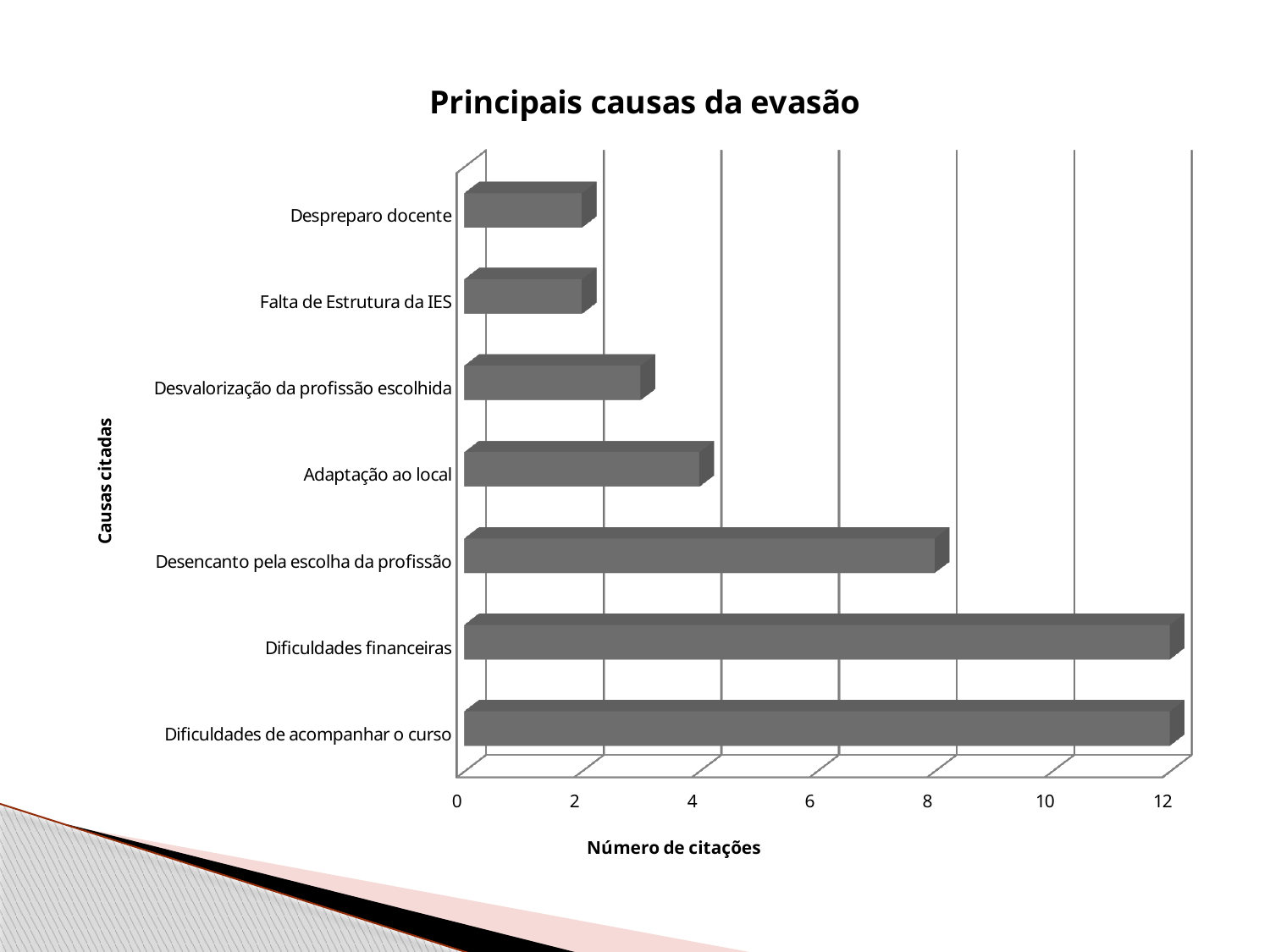
What is the number of citations for Desencanto pela escolha da profissão? 8 Which has more citations, Dificuldades financeiras or Desencanto pela escolha da profissão? Dificuldades financeiras Is the value for Desvalorização da profissão escolhida greater or less than 2? greater How many causes (categories) are plotted in the chart? 7 What is the title of the chart? Principais causas da evasão What is the label of the horizontal axis? Número de citações Is the value for Dificuldades de acompanhar o curso greater or less than 10? greater What kind of chart is shown on the slide? bar chart What is the number of citations for Dificuldades financeiras? 12 Is the value for Adaptação ao local greater or less than 6? less Which has more citations, Adaptação ao local or Falta de Estrutura da IES? Adaptação ao local